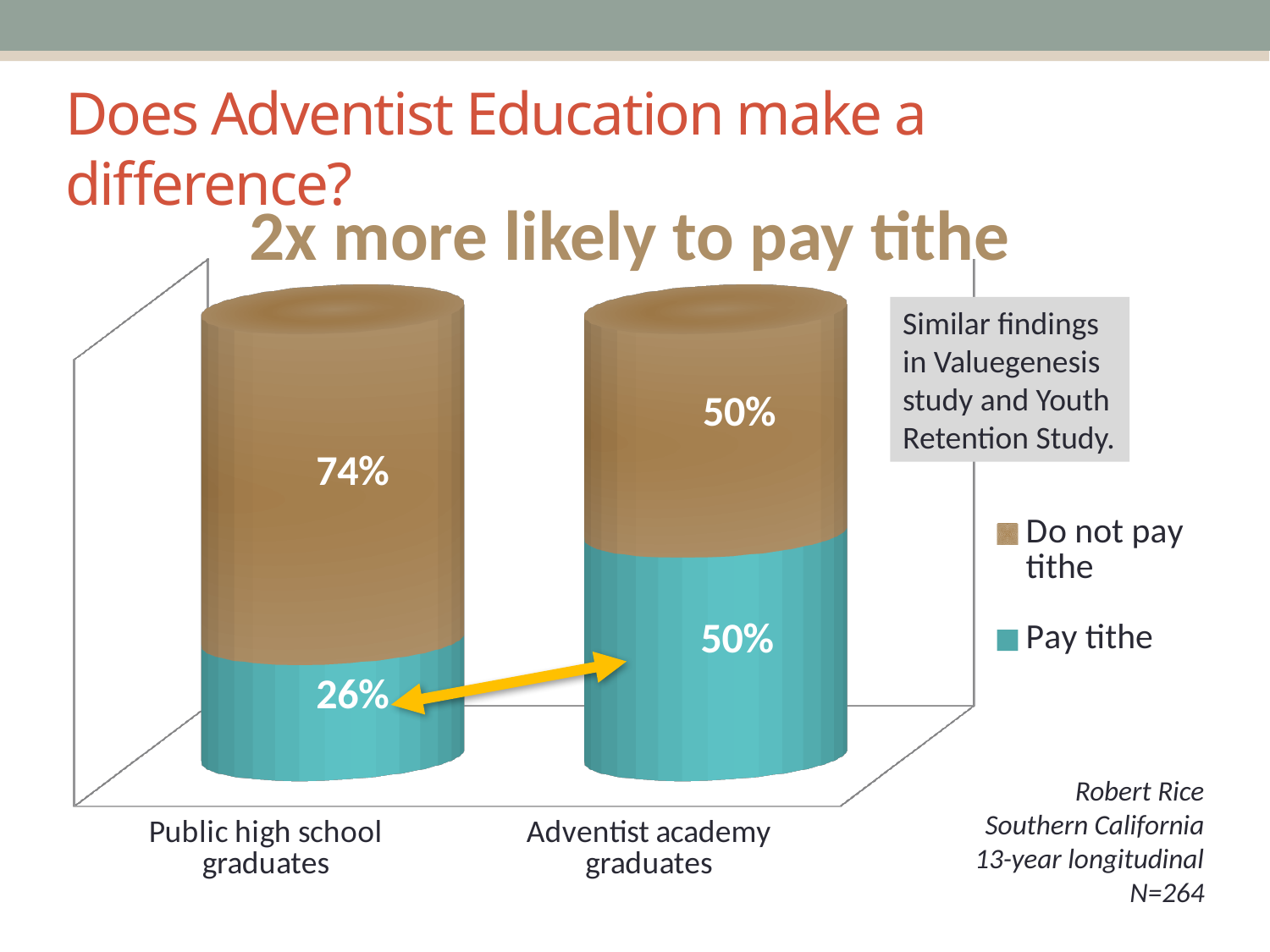
What is the title of the chart? 2x more likely to pay tithe Which group has the highest 'Do not pay tithe' percentage? Public high school graduates What is the difference in the 'Do not pay tithe' percentage between public high school graduates and Adventist academy graduates? 24% What is the difference in the 'Pay tithe' percentage between Adventist academy graduates and public high school graduates? 24% Which group has the higher share paying tithe, public high school graduates or Adventist academy graduates? Adventist academy graduates What percentage of public high school graduates do not pay tithe? 74% What percentage of Adventist academy graduates do not pay tithe? 50% What type of chart is shown on the slide? Stacked bar chart What percentage of public high school graduates pay tithe? 26% How many categories are shown on the x axis of the chart? 2 What percentage of Adventist academy graduates pay tithe? 50% How many series does the chart legend list? 2